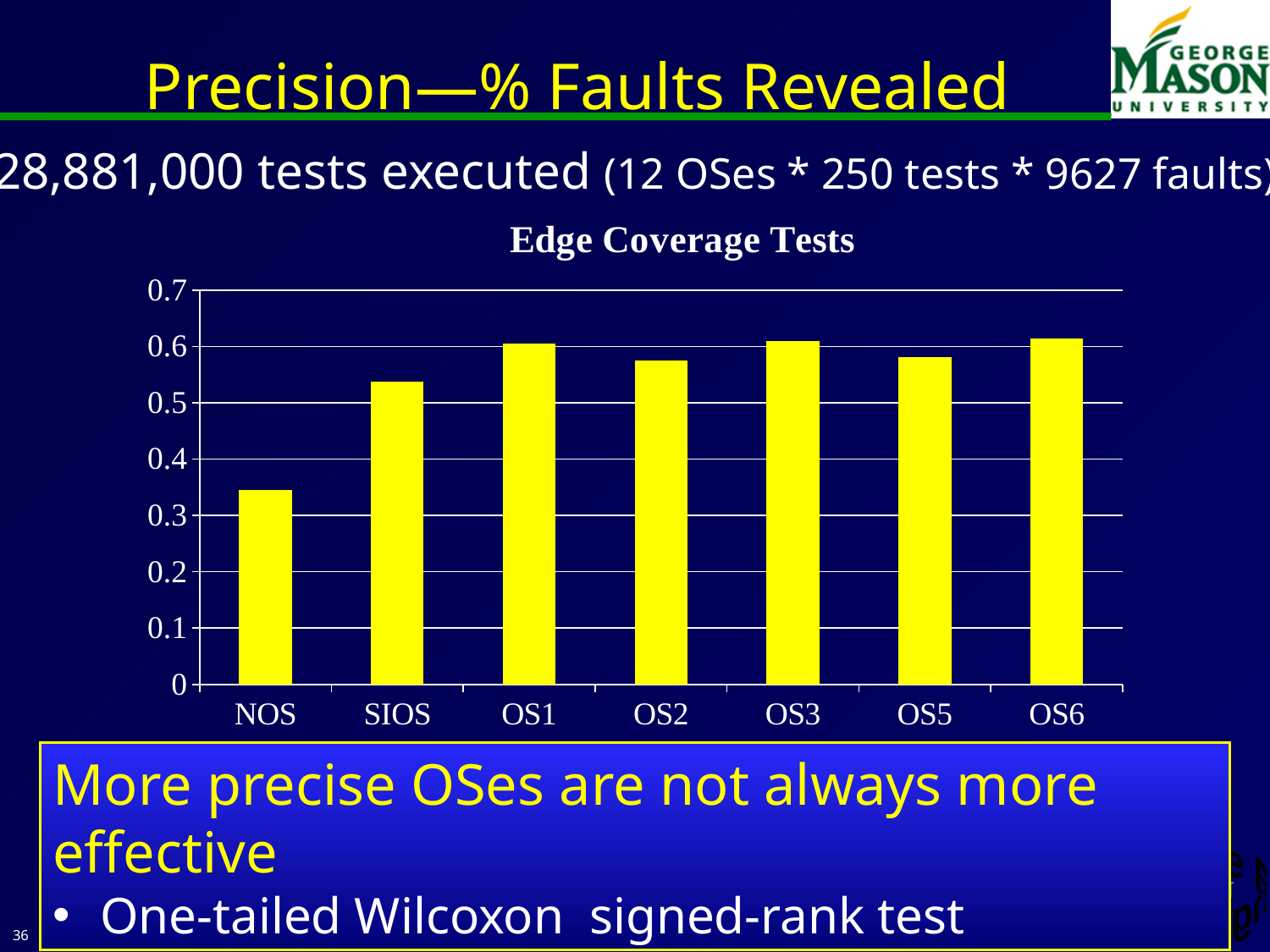
Is the value for OS6 greater or less than 0.5? greater Is the value for OS2 greater or less than 0.6? less Which has the larger value, NOS or SIOS? SIOS Which has the larger value, OS1 or OS2? OS1 What is the title of the chart? Edge Coverage Tests What kind of chart is shown on the slide? bar chart Is the value for NOS greater or less than 0.3? greater Which category has the lowest value in the chart? NOS How many categories are shown on the x axis of the chart? 7 What is the highest value shown on the y axis of the chart? 0.7